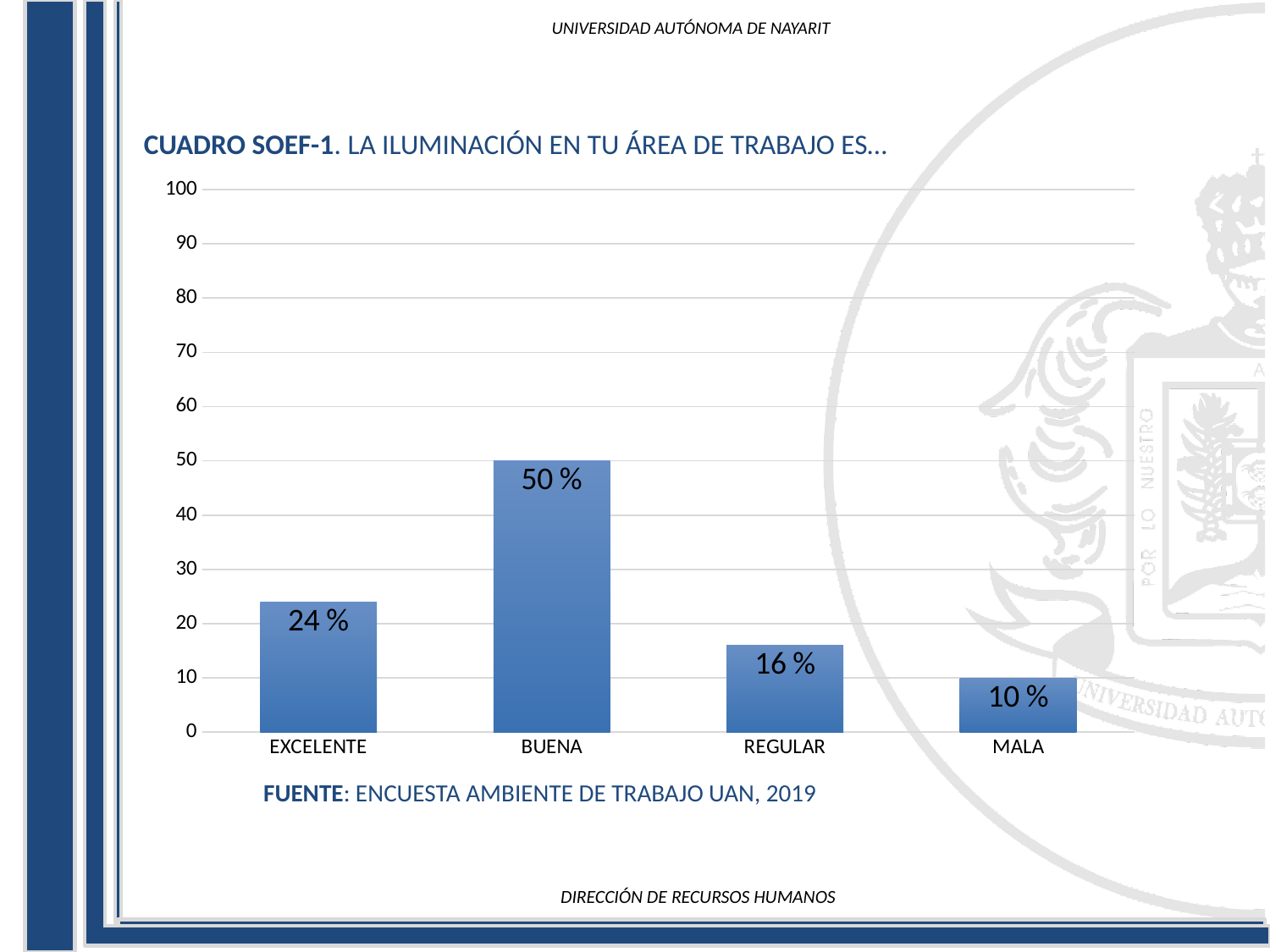
What is the value for BUENA? 50 % Which category has the highest value? BUENA What kind of chart is shown on the slide? Bar chart What is the value for REGULAR? 16 % What is the title of the chart? CUADRO SOEF-1. LA ILUMINACIÓN EN TU ÁREA DE TRABAJO ES… Which is larger, the value for EXCELENTE or the value for REGULAR? EXCELENTE What is the value for MALA? 10 % What is the difference between the values for BUENA and EXCELENTE? 26 % What is the difference between the values for REGULAR and MALA? 6 % How many categories are shown on the x axis? 4 Which category has the lowest value? MALA What is the value for EXCELENTE? 24 %